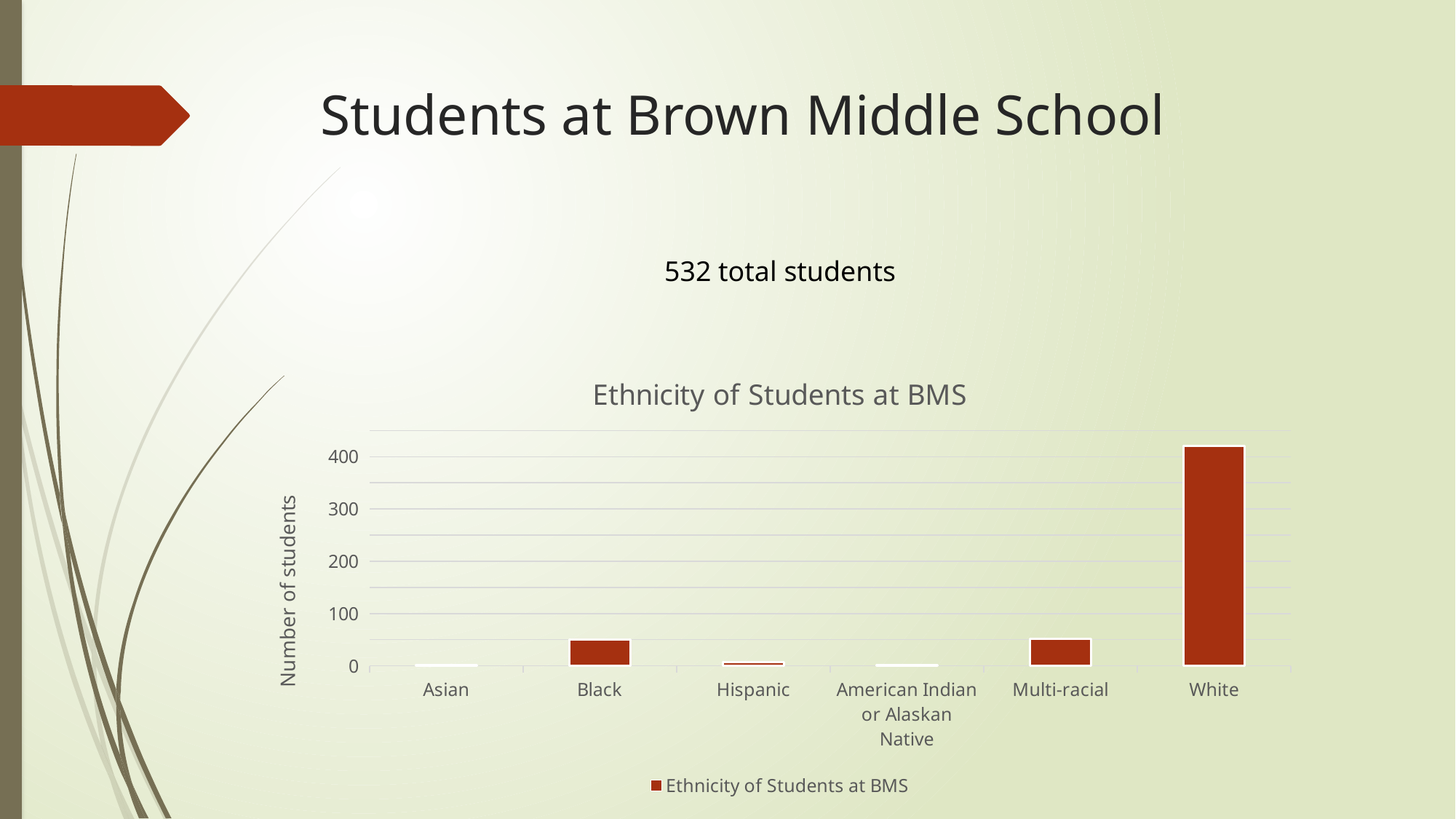
How many ethnicity categories are shown on the x axis of the chart? 6 Is the value for Black greater or less than 100? less Is the value for Multi-racial greater or less than 100? less Which is larger, the value for White or the value for Black? White Which ethnicity category has the highest number of students? White Is the value for White greater or less than 400? greater What kind of chart is shown on the slide? bar chart What is the label on the vertical axis of the chart? Number of students What is the title of the chart? Ethnicity of Students at BMS How many series does the chart legend list? 1 Which is larger, the value for Multi-racial or the value for Hispanic? Multi-racial